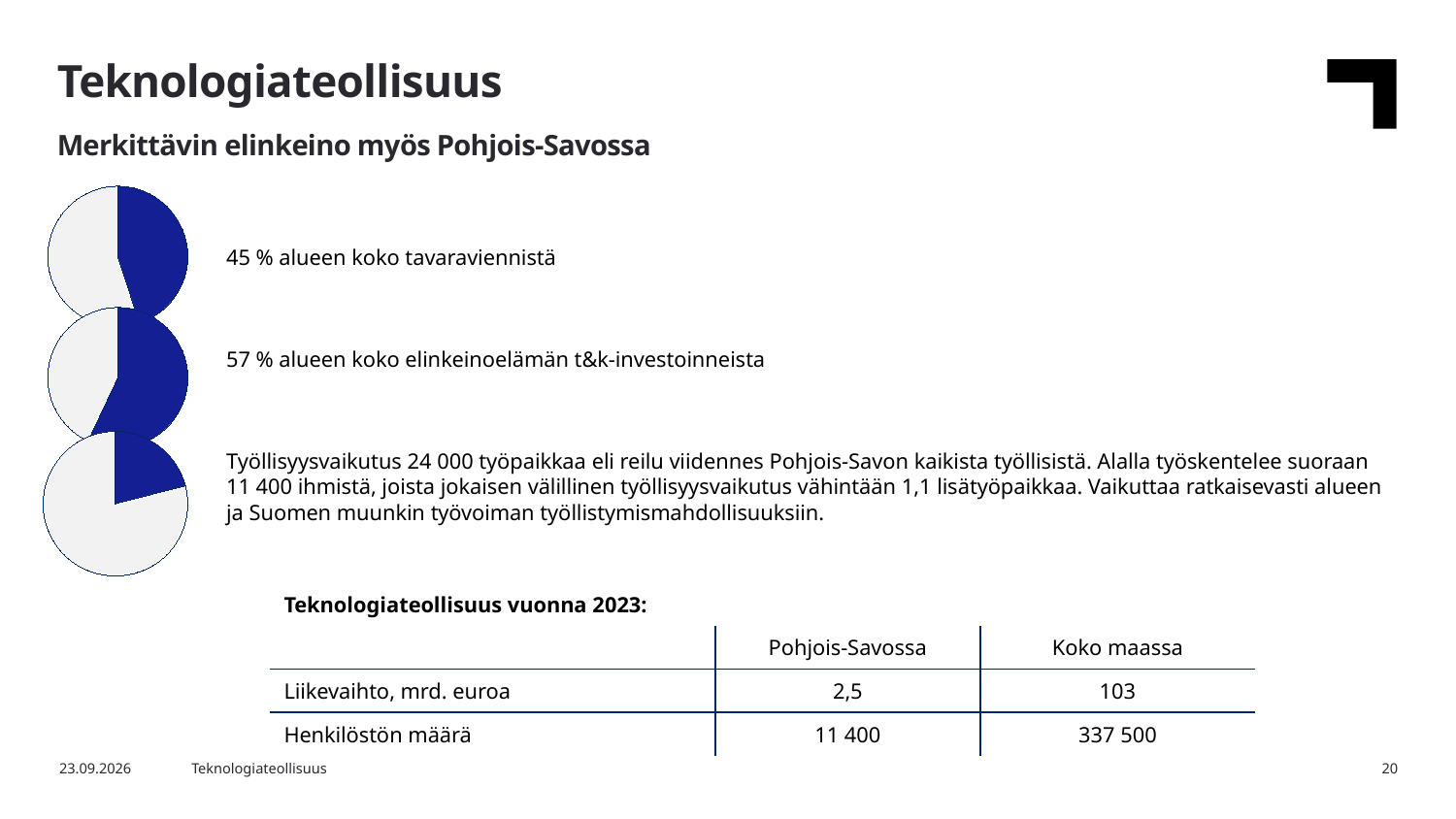
What kind of charts are shown on the left side of the slide? Pie charts What colour is used for the highlighted slice in each pie chart? Dark blue Is the blue slice in the middle pie chart greater or less than half of the pie? greater Which pie chart has the smallest blue slice: the top, middle or bottom one? Bottom What text accompanies the top pie chart? 45 % alueen koko tavaraviennistä Which pie chart has the largest blue slice: the top, middle or bottom one? Middle What is the difference in percentage points between the blue shares of the middle and top pie charts? 12 percentage points Is the blue slice in the bottom pie chart greater or less than half of the pie? less How many pie charts are on the slide? 3 Is the blue slice larger in the top pie chart or in the middle pie chart? Middle In the middle pie chart, what share of the region's business R&D investments does the blue slice represent? 57 % In the top pie chart, what share of the region's total goods exports does the blue slice represent? 45 %